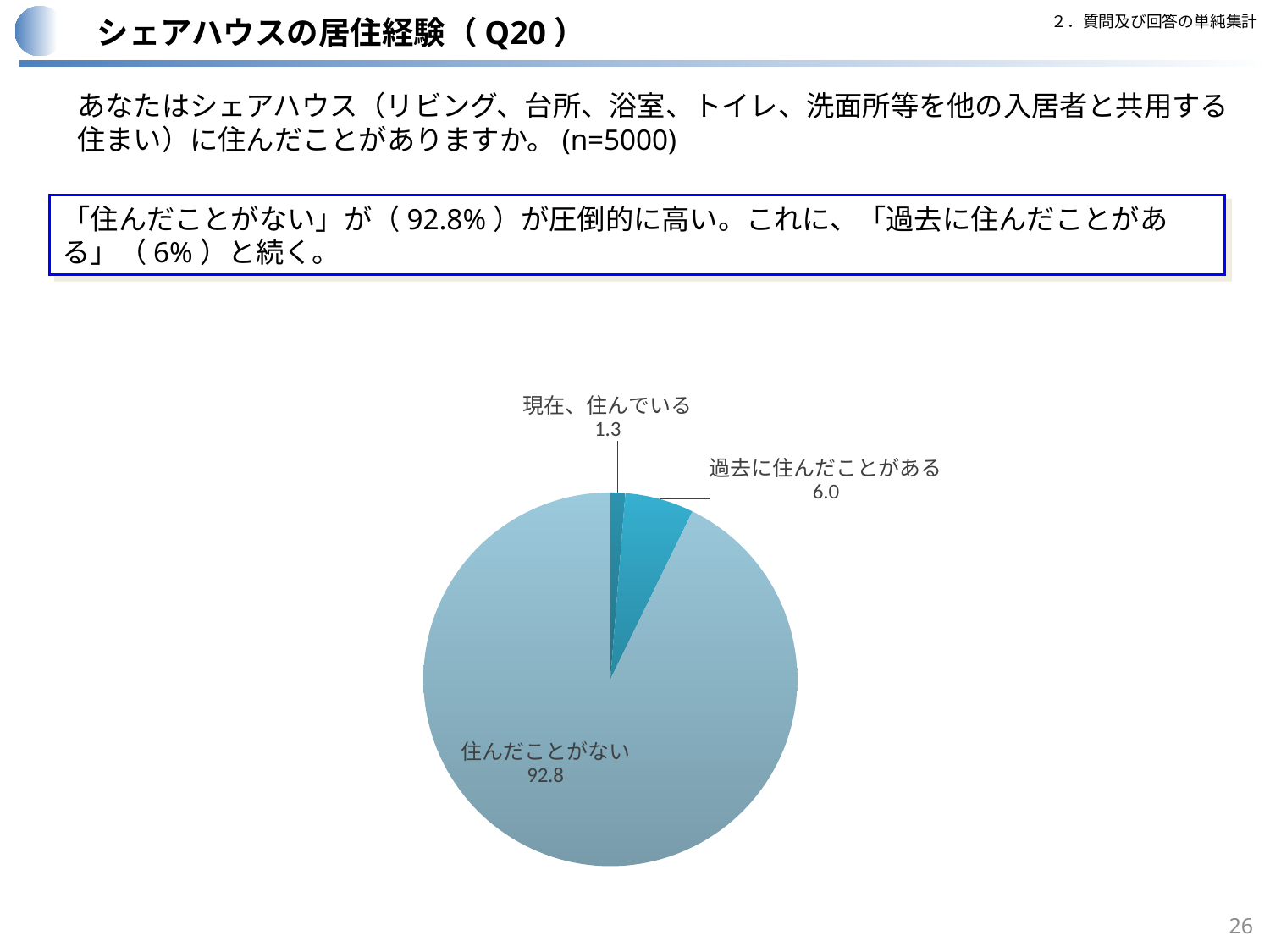
Which category has the largest slice? 住んだことがない What is the value for 住んだことがない? 92.8 What is the difference between the values for 住んだことがない and 過去に住んだことがある? 86.8 How many categories does the pie chart show? 3 What is the difference between the values for 過去に住んだことがある and 現在、住んでいる? 4.7 What kind of chart is shown on the slide? pie chart What is the value for 現在、住んでいる? 1.3 What is the sample size (n) stated on the slide for this question? 5000 What is the value for 過去に住んだことがある? 6.0 Which category has the smallest slice? 現在、住んでいる What is the total of the three values shown in the pie chart? 100.1 Which is larger, the value for 過去に住んだことがある or the value for 現在、住んでいる? 過去に住んだことがある